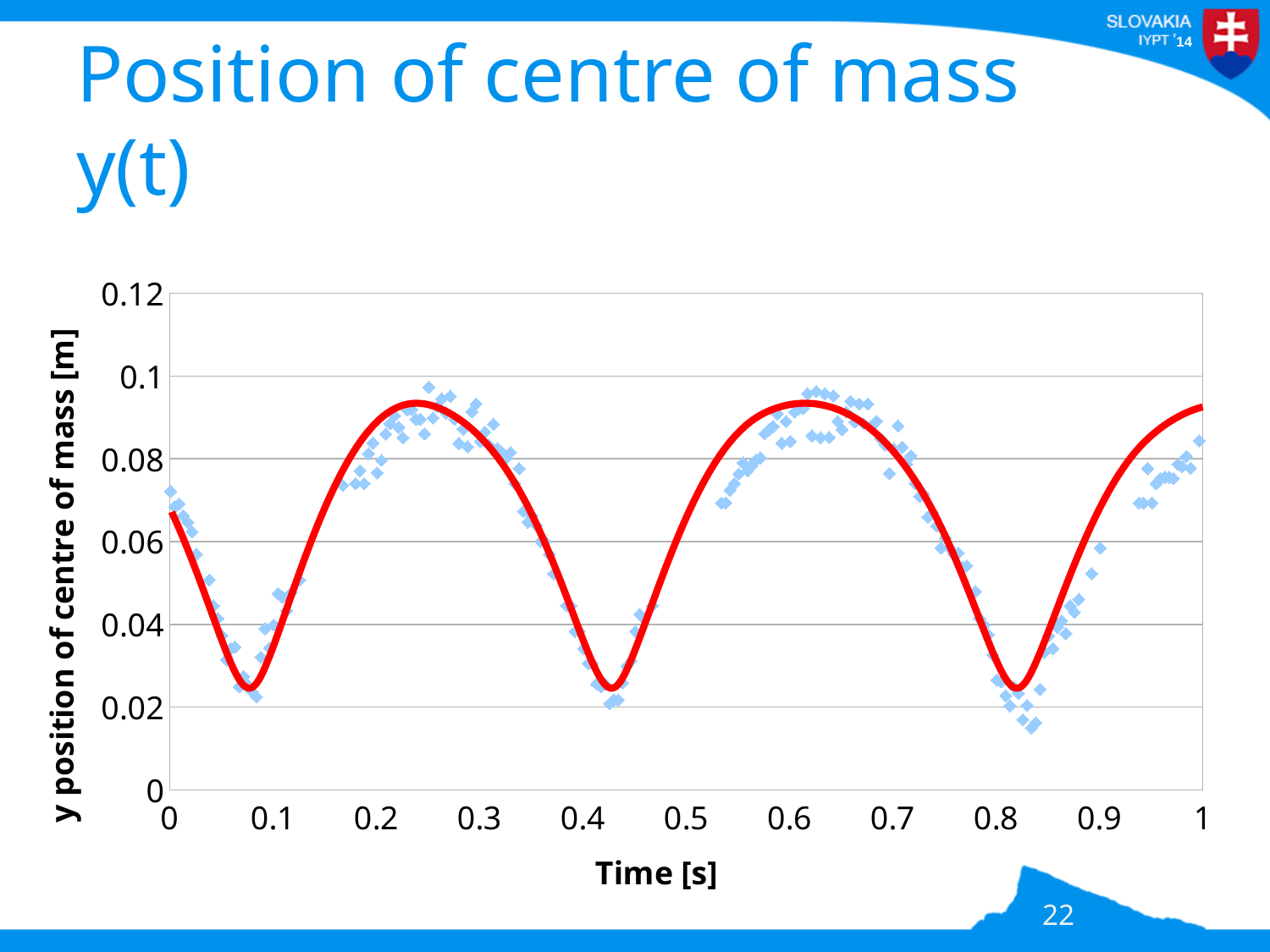
Does the red curve rise or fall between time 0.65 s and 0.8 s? fall Is the value of the red curve at time 0.6 s greater or less than 0.08? greater Is the value of the red curve at time 0.4 s greater or less than 0.06? less How many tick labels are shown on the x axis? 11 Does the red curve rise or fall between time 0.1 s and 0.2 s? rise What is the label of the y axis? y position of centre of mass [m] Is the highest value reached by the red curve greater or less than 0.1? less Does the red curve rise or fall between time 0.3 s and 0.4 s? fall What is the label of the x axis? Time [s] What kind of chart is shown on the slide? scatter chart with a fitted curve